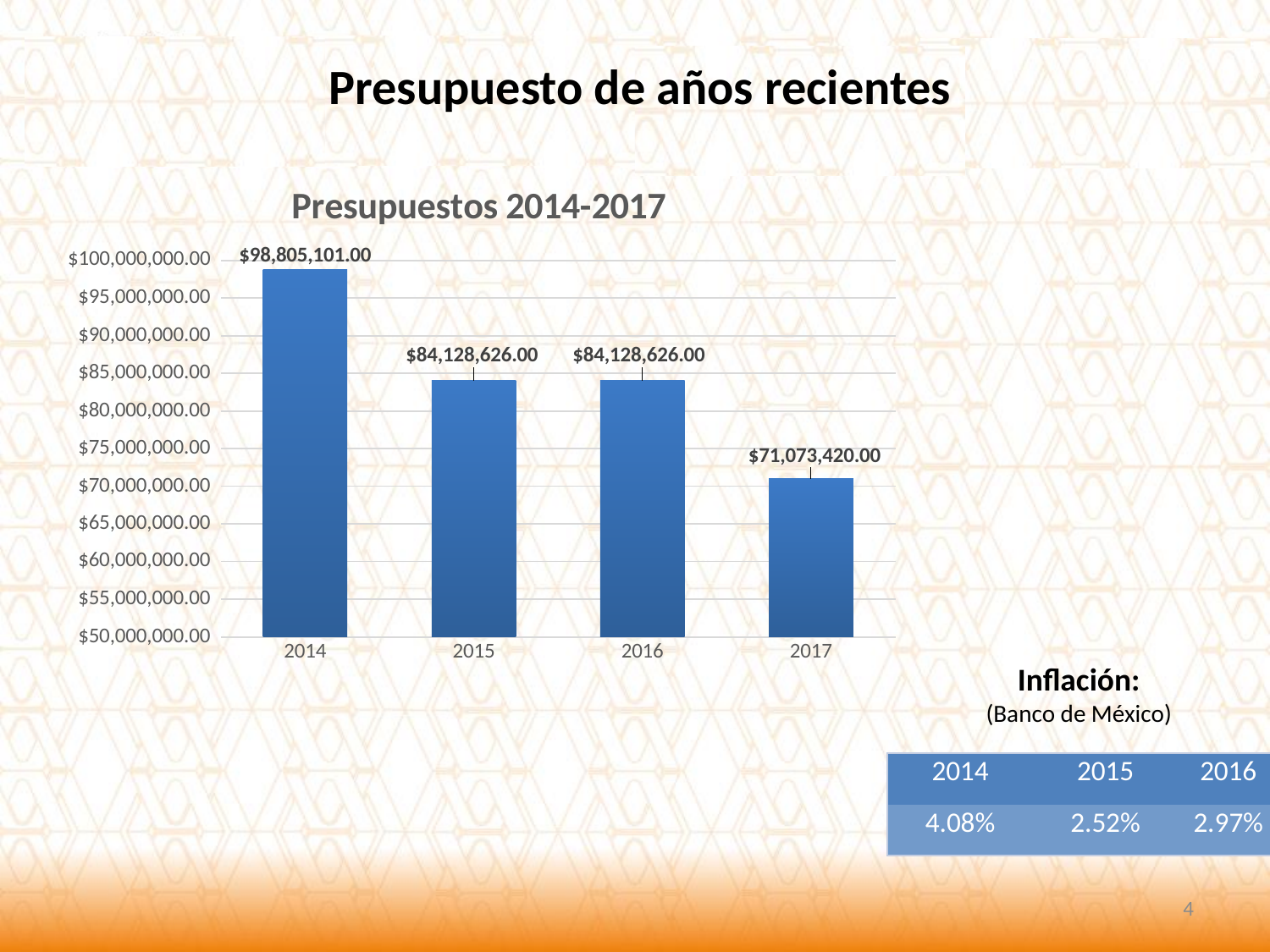
Which year has the highest budget in the Presupuestos 2014-2017 chart? 2014 In the Presupuestos 2014-2017 chart, is the value for 2017 greater or less than $75,000,000.00? less What is the difference between the 2016 and 2017 budgets in the Presupuestos 2014-2017 chart? $13,055,206.00 What is the budget value shown for 2017 in the Presupuestos 2014-2017 chart? $71,073,420.00 Which year has the lowest budget in the Presupuestos 2014-2017 chart? 2017 In the Presupuestos 2014-2017 chart, is the 2015 budget larger than, smaller than, or equal to the 2016 budget? equal What is the difference between the 2014 and 2015 budgets in the Presupuestos 2014-2017 chart? $14,676,475.00 What is the budget value shown for 2014 in the Presupuestos 2014-2017 chart? $98,805,101.00 What is the budget value shown for 2015 in the Presupuestos 2014-2017 chart? $84,128,626.00 What kind of chart is the Presupuestos 2014-2017 chart? bar chart Do the budget values in the Presupuestos 2014-2017 chart generally rise or fall from 2014 to 2017? fall How many years are plotted in the Presupuestos 2014-2017 chart? 4